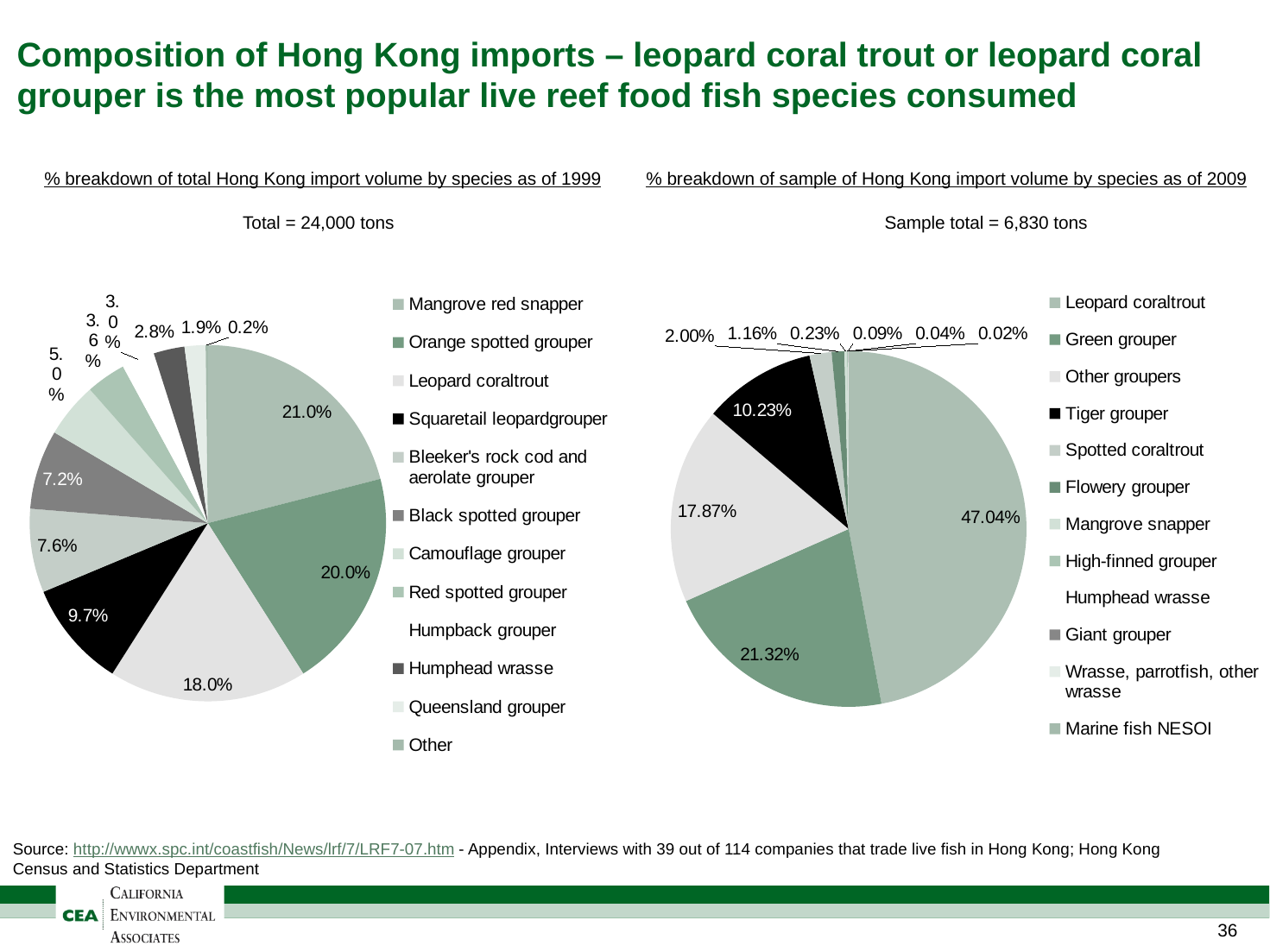
In the 2009 chart (right), what percentage is shown for tiger grouper? 10.23% In the 2009 chart (right), what percentage is shown for green grouper? 21.32% In the 1999 chart (left), which is larger: the share for orange spotted grouper (20.0%) or leopard coraltrout (18.0%)? Orange spotted grouper In the 1999 chart (left), what percentage is shown for squaretail leopardgrouper (the black slice)? 9.7% In the 1999 chart (left), what percentage is shown for the largest slice, mangrove red snapper? 21.0% In the 2009 chart (right), what share of the sample import volume is leopard coraltrout? 47.04% In the 1999 chart (left), which species has the largest share? Mangrove red snapper In the 2009 chart (right), which species has the largest share? Leopard coraltrout What type of chart is used on this slide to show the breakdown of Hong Kong imports? Pie chart In the 2009 chart (right), what is the difference in percentage points between leopard coraltrout (47.04%) and green grouper (21.32%)? 25.72 What is the sample total in tons stated above the 2009 chart (right)? 6,830 tons How many species entries does the legend of the 2009 chart (right) list? 12